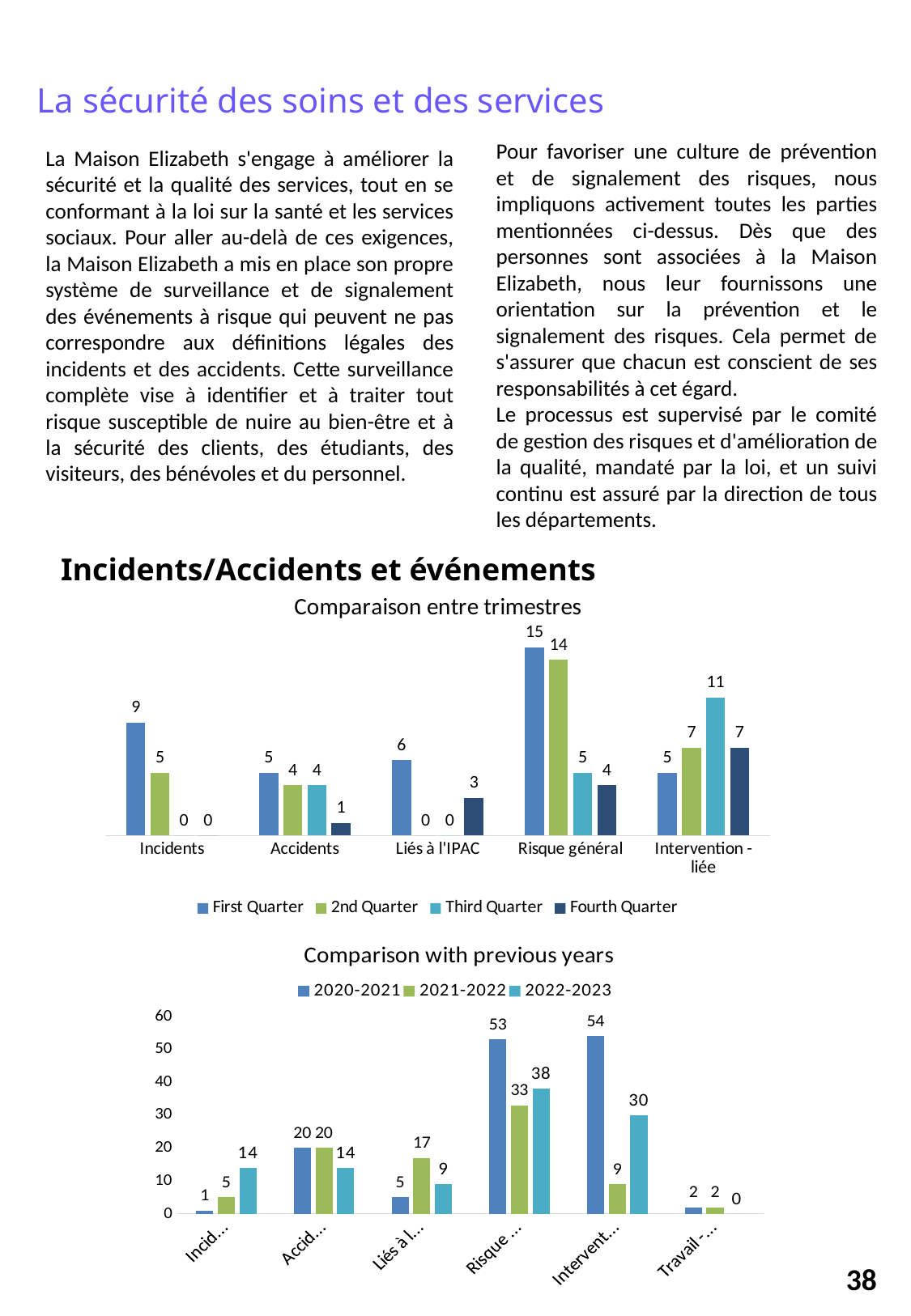
In the 'Comparaison entre trimestres' chart, which is larger for Accidents: the First Quarter value or the Fourth Quarter value? First Quarter How many categories are shown on the x axis of the 'Comparaison entre trimestres' chart? 5 How many series does the legend of the 'Comparaison entre trimestres' chart list? 4 In the 'Comparaison entre trimestres' chart, which category has the highest First Quarter value? Risque général What kind of chart is 'Comparison with previous years'? Bar chart In the 'Comparaison entre trimestres' chart, what is the Third Quarter value for Intervention - liée? 11 In the 'Comparaison entre trimestres' chart, what is the Fourth Quarter value for Liés à l'IPAC? 3 How many series does the legend of the 'Comparison with previous years' chart list? 3 In the 'Comparison with previous years' chart, what is the highest value shown for the 2020-2021 series? 54 In the 'Comparison with previous years' chart, what is the difference between the 2020-2021 value (53) and the 2021-2022 value (33) in the 'Risque ...' category? 20 In the 'Comparaison entre trimestres' chart, what is the First Quarter value for Risque général? 15 In the 'Comparaison entre trimestres' chart, what is the difference between the First Quarter and 2nd Quarter values for Incidents? 4